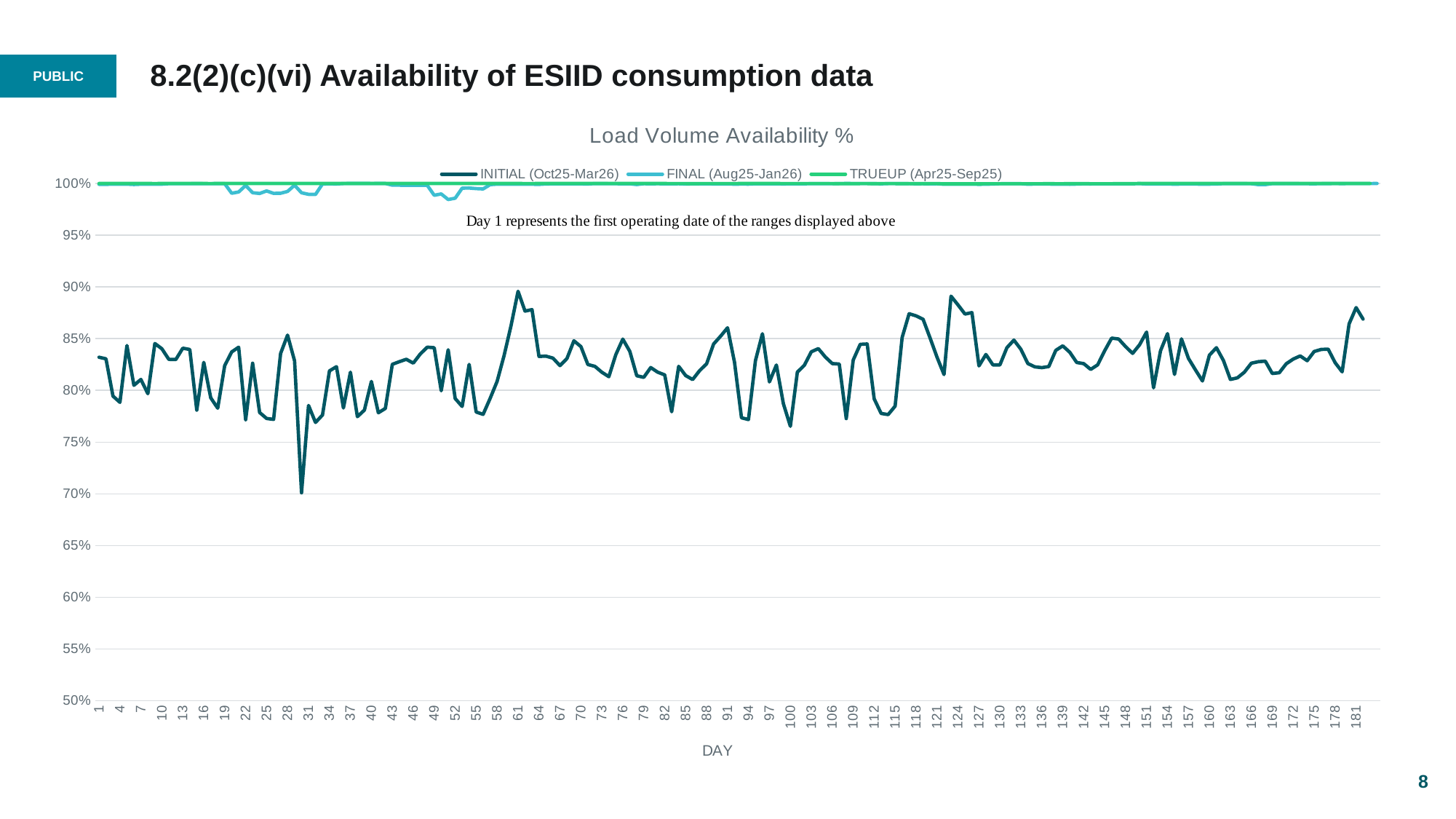
How many series does the legend list? 3 What is the label of the x axis? DAY Is the value of the INITIAL (Oct25-Mar26) series at day 100 greater or less than 80%? less Is the value of the TRUEUP (Apr25-Sep25) series at day 100 greater or less than 95%? greater Which series has the lowest values across the chart? INITIAL (Oct25-Mar26) Which series reaches the lowest single value on the chart? INITIAL (Oct25-Mar26) Is the value of the FINAL (Aug25-Jan26) series at day 22 greater or less than 95%? greater At day 1, which series has the higher value: INITIAL (Oct25-Mar26) or FINAL (Aug25-Jan26)? FINAL (Aug25-Jan26) What kind of chart is shown on the slide? line chart What is the title of the chart? Load Volume Availability %